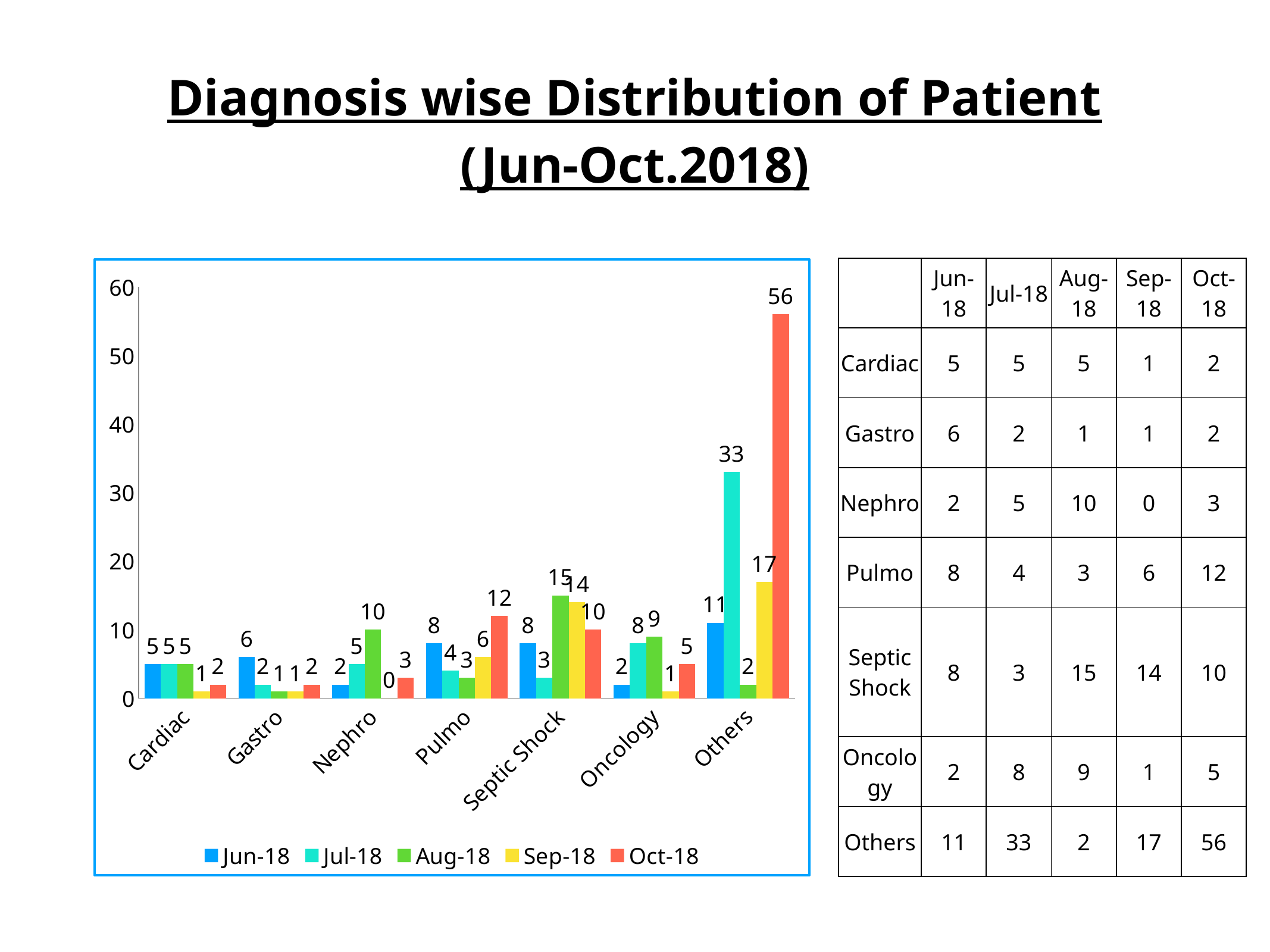
How many diagnosis categories are shown on the x axis of the chart? 7 Which is larger for Pulmo: the Jun-18 value or the Oct-18 value? Oct-18 Which category has the highest Jul-18 value? Others What is the value for Others in Oct-18? 56 What is the value for Septic Shock in Sep-18? 14 How many series does the chart legend list? 5 What is the value for Nephro in Aug-18? 10 What is the difference between the Oct-18 and Jul-18 values for Others? 23 Which colour represents the Oct-18 series in the chart? red Which category has the lowest Sep-18 value? Nephro What type of chart is shown on the slide? bar chart Is the value for Others in Jul-18 greater or less than 30? greater